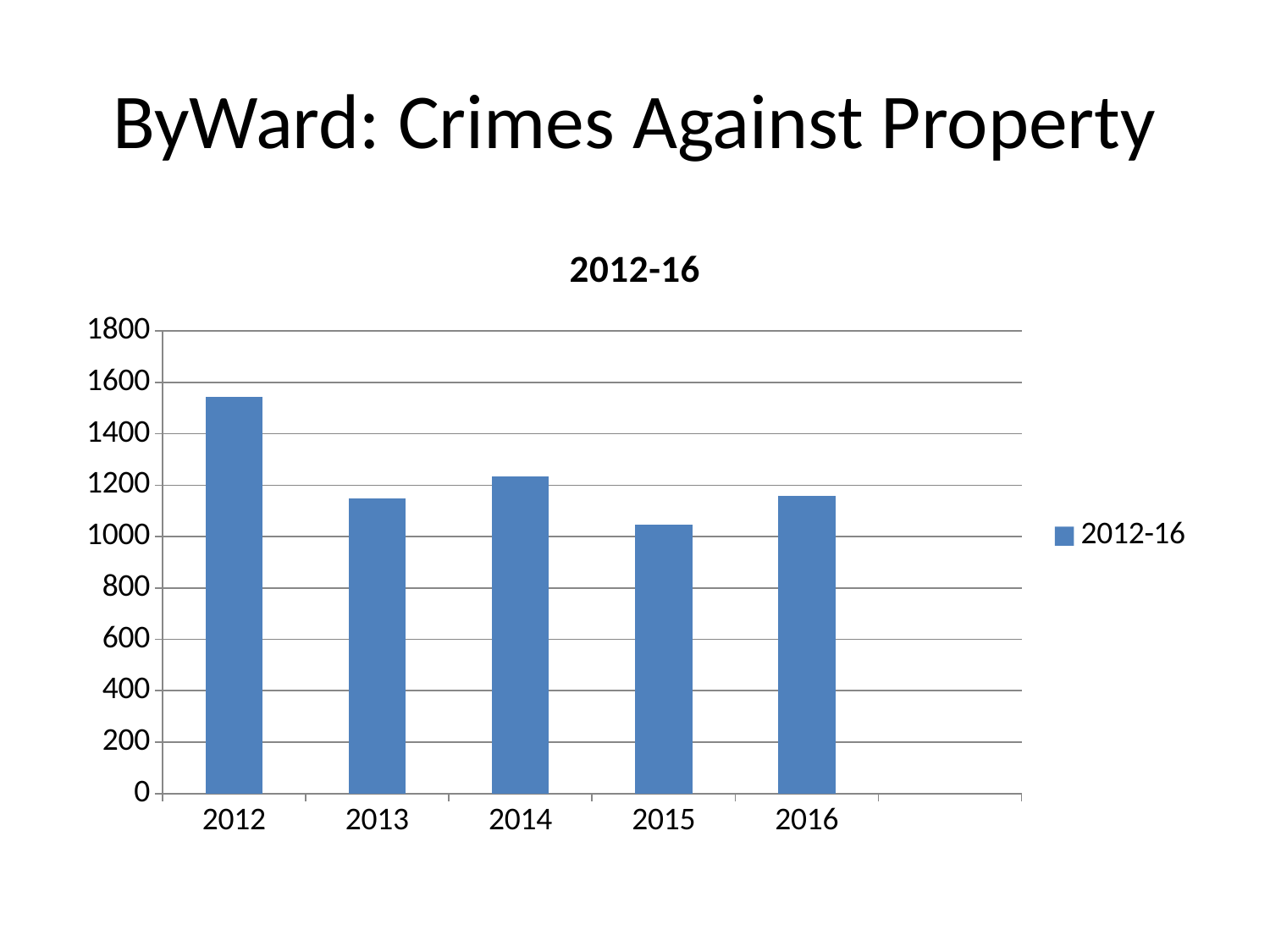
How many series does the legend list? 1 Which year has the highest value? 2012 Which year has the lowest value? 2015 Is the value for 2015 greater or less than 1000? greater How many years are plotted on the chart? 5 Which is larger, the value for 2014 or the value for 2015? 2014 What kind of chart is shown on the slide? bar chart Which is larger, the value for 2012 or the value for 2013? 2012 Is the value for 2012 greater or less than 1400? greater What is the title shown above the chart? 2012-16 Is the value for 2014 greater or less than 1200? greater